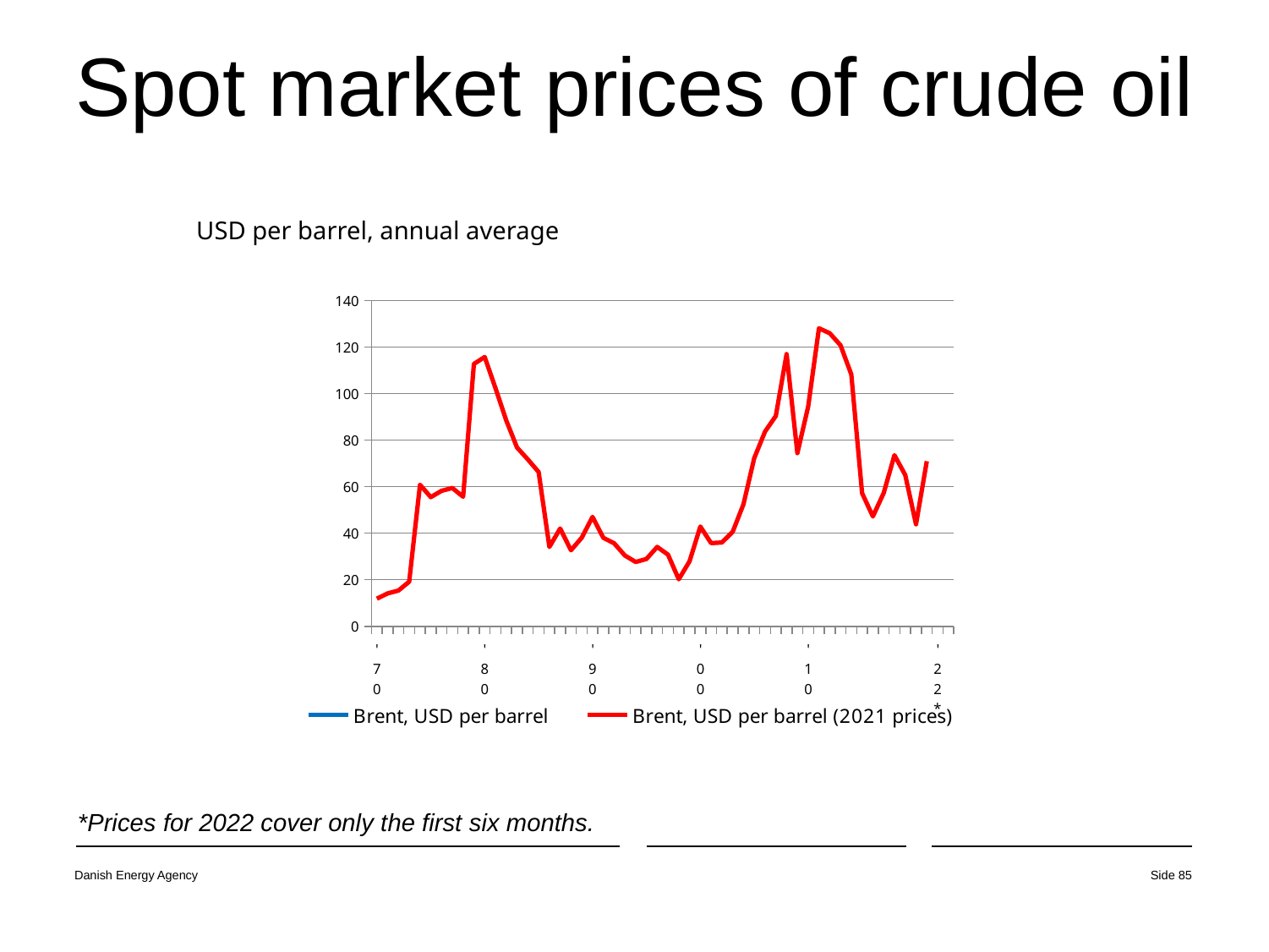
What is the highest value shown on the chart's vertical axis? 140 Does the 'Brent, USD per barrel (2021 prices)' line rise or fall between 1970 and 1980? rise Is the peak of the 'Brent, USD per barrel (2021 prices)' line around 1980 greater or less than 100? greater What subtitle is shown above the chart describing the units? USD per barrel, annual average Does the 'Brent, USD per barrel (2021 prices)' line rise or fall between its peak around 2011 and 2016? fall What colour is the line for 'Brent, USD per barrel (2021 prices)'? red Is the highest value of the 'Brent, USD per barrel (2021 prices)' line greater or less than 120? greater How many series does the chart legend list? 2 Is the lowest value of the 'Brent, USD per barrel (2021 prices)' line in the late 1990s greater or less than 40? less What kind of chart is shown on the slide? line chart